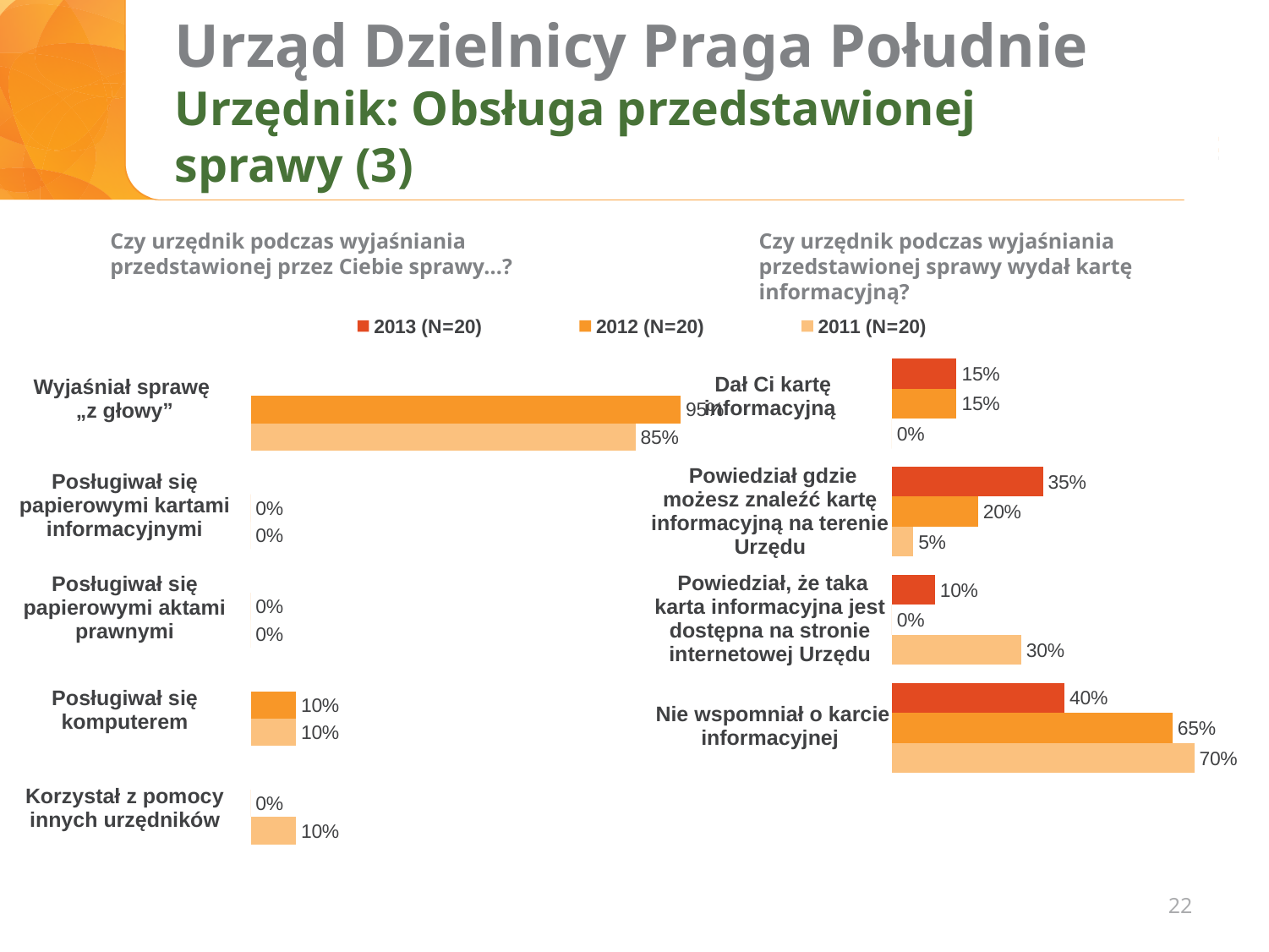
In the right chart, what is the 2011 value for "Powiedział, że taka karta informacyjna jest dostępna na stronie internetowej Urzędu"? 30% In the left chart, what is the 2011 value for "Korzystał z pomocy innych urzędników"? 10% What type of chart is the right chart? Bar chart In the right chart, what is the 2011 value for "Nie wspomniał o karcie informacyjnej"? 70% In the right chart, what is the 2013 value for "Powiedział gdzie możesz znaleźć kartę informacyjną na terenie Urzędu"? 35% In the right chart, which category has the highest 2012 value? Nie wspomniał o karcie informacyjnej In the right chart, what is the difference between the 2012 and 2013 values for "Nie wspomniał o karcie informacyjnej"? 25% How many series does the legend list? 3 In the left chart ("Czy urzędnik podczas wyjaśniania przedstawionej przez Ciebie sprawy...?"), what is the 2011 value for "Wyjaśniał sprawę „z głowy”"? 85% In the right chart, for "Powiedział gdzie możesz znaleźć kartę informacyjną na terenie Urzędu", which year has the larger value, 2013 or 2011? 2013 How many categories does the left chart show? 5 In the right chart ("Czy urzędnik podczas wyjaśniania przedstawionej sprawy wydał kartę informacyjną?"), what is the 2013 value for "Nie wspomniał o karcie informacyjnej"? 40%